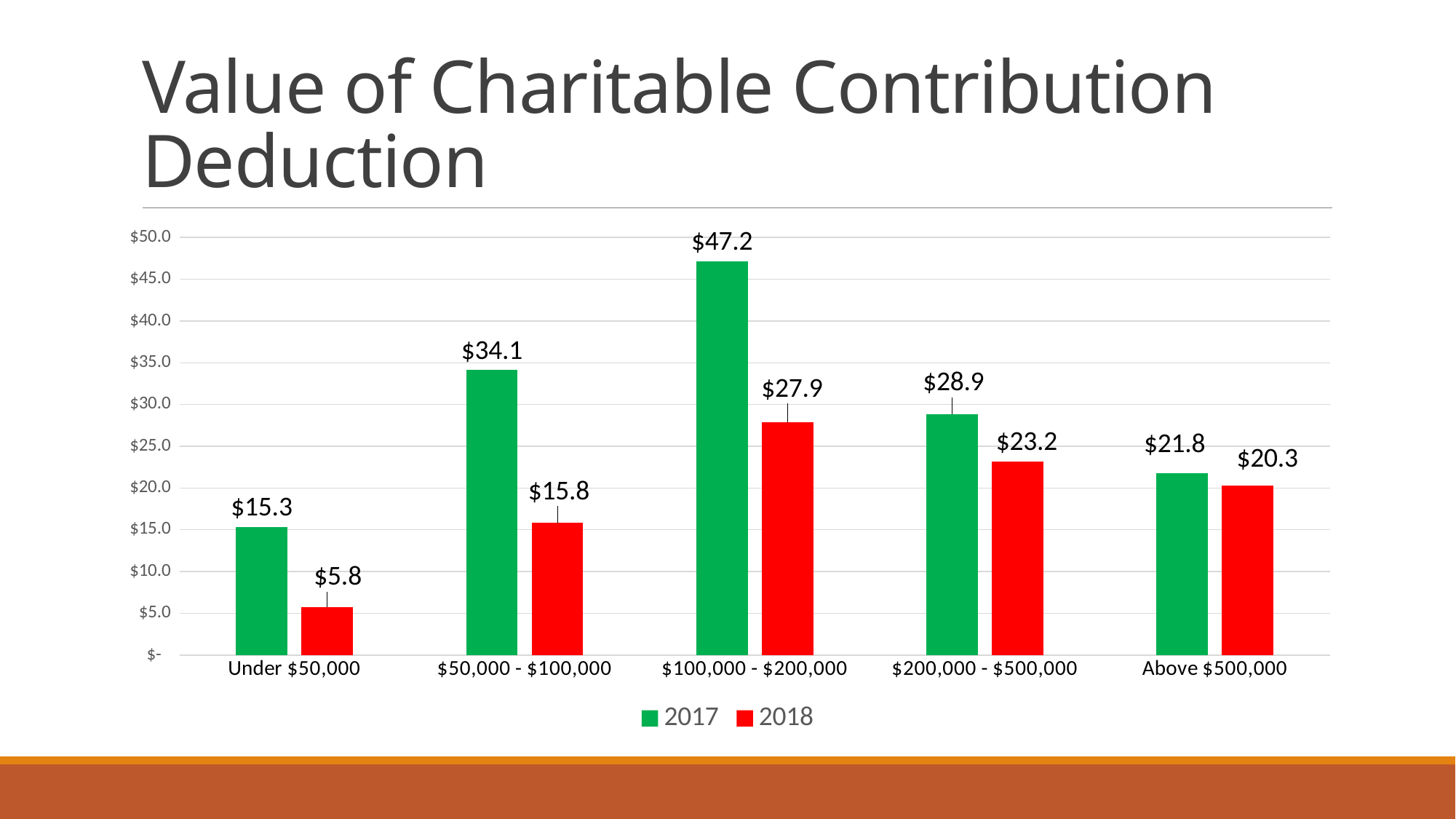
What is the title of the slide? Value of Charitable Contribution Deduction What is the 2018 value for the Above $500,000 income group? $20.3 What is the 2018 value for the Under $50,000 income group? $5.8 Which income group has the lowest 2018 value? Under $50,000 How many series does the legend list? 2 How many income groups are shown on the x axis? 5 Which income group has the highest 2017 value? $100,000 - $200,000 What kind of chart is shown on the slide? Bar chart What is the 2017 value for the $100,000 - $200,000 income group? $47.2 Which colour represents the 2018 series? Red Which is larger for the $200,000 - $500,000 group, the 2017 value or the 2018 value? 2017 What is the difference between the 2017 and 2018 values for the $50,000 - $100,000 group? $18.3